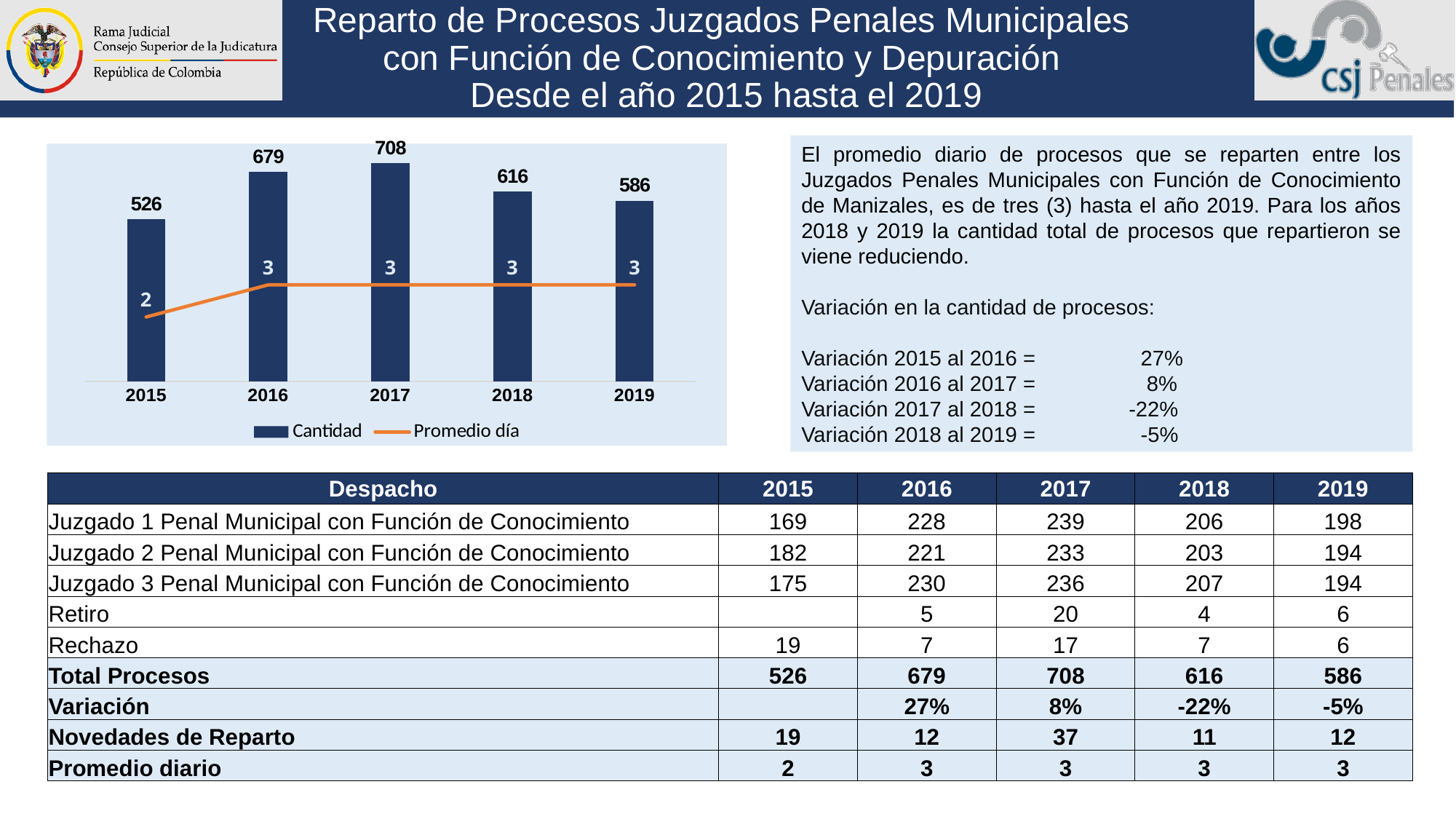
What is the difference in Cantidad between 2017 and 2019? 122 How many years are shown on the x axis of the chart? 5 Which year has a larger Cantidad, 2016 or 2018? 2016 How many series does the chart legend list? 2 Does the Cantidad series rise or fall from 2017 to 2019? Fall What is the Promedio día value for 2015? 2 Which year has the highest Cantidad? 2017 What is the Cantidad value for 2017? 708 What is the Cantidad value for 2015? 526 What colour is the Promedio día line in the chart? Orange What kind of chart is used to show the Cantidad series? Bar chart Which year has the lowest Cantidad? 2015